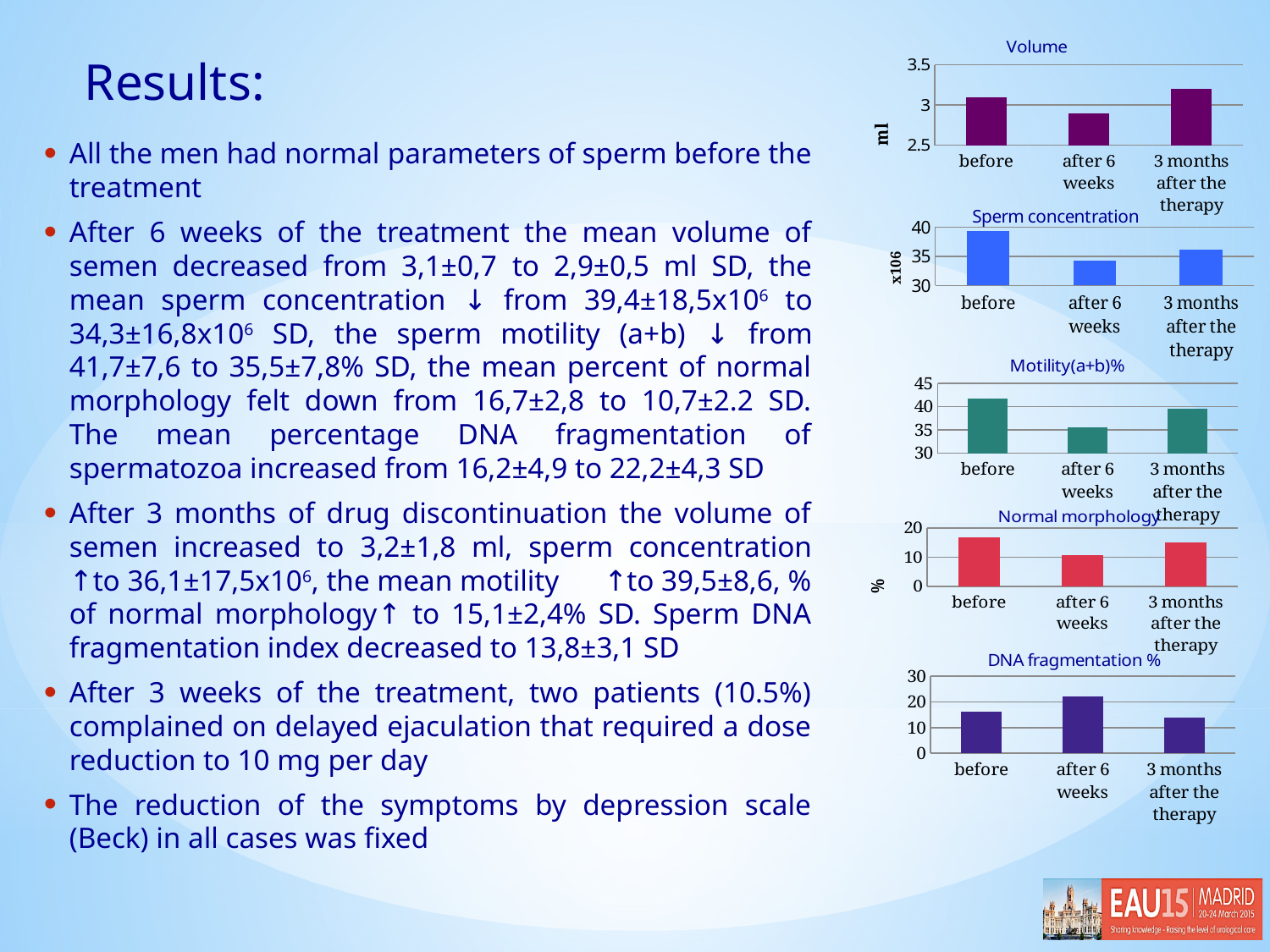
In the Motility(a+b)% chart, which category has the highest value? before How many categories are shown on the x axis of the Volume chart? 3 In the DNA fragmentation % chart, which category has the highest value? after 6 weeks In the Motility(a+b)% chart, is the value for 'before' greater or less than 40? greater In the DNA fragmentation % chart, is the value for 'after 6 weeks' greater or less than 20? greater In the Sperm concentration chart, is the value for 'before' greater or less than 35? greater In the Volume chart, which category has the highest value? 3 months after the therapy In the Normal morphology chart, which is larger: the value for 'before' or the value for 'after 6 weeks'? before In the DNA fragmentation % chart, which category has the lowest value? 3 months after the therapy What type of chart is the Sperm concentration chart? bar chart In the Sperm concentration chart, which category has the lowest value? after 6 weeks